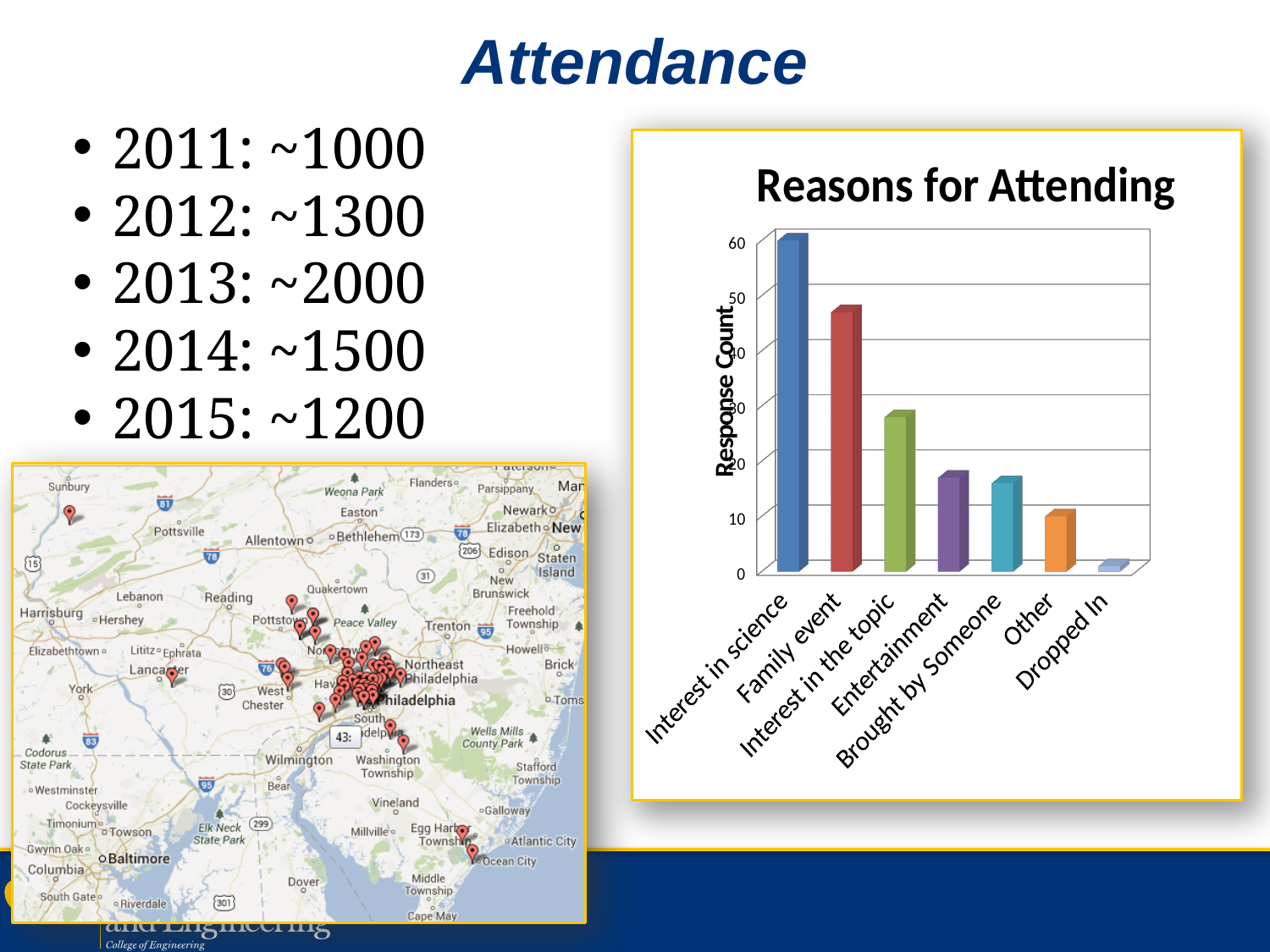
What type of chart is shown on the slide? bar chart How many categories are shown on the x axis of the chart? 7 What is the label on the vertical axis of the chart? Response Count Which has a higher response count, Family event or Entertainment? Family event Is the response count for Other greater or less than 20? less What is the title of the chart? Reasons for Attending Do the response counts rise or fall moving from left to right along the x axis? fall Is the response count for Family event greater or less than 40? greater Which reason for attending has the highest response count? Interest in science Is the response count for Interest in the topic greater or less than 30? less Which reason for attending has the lowest response count? Dropped In